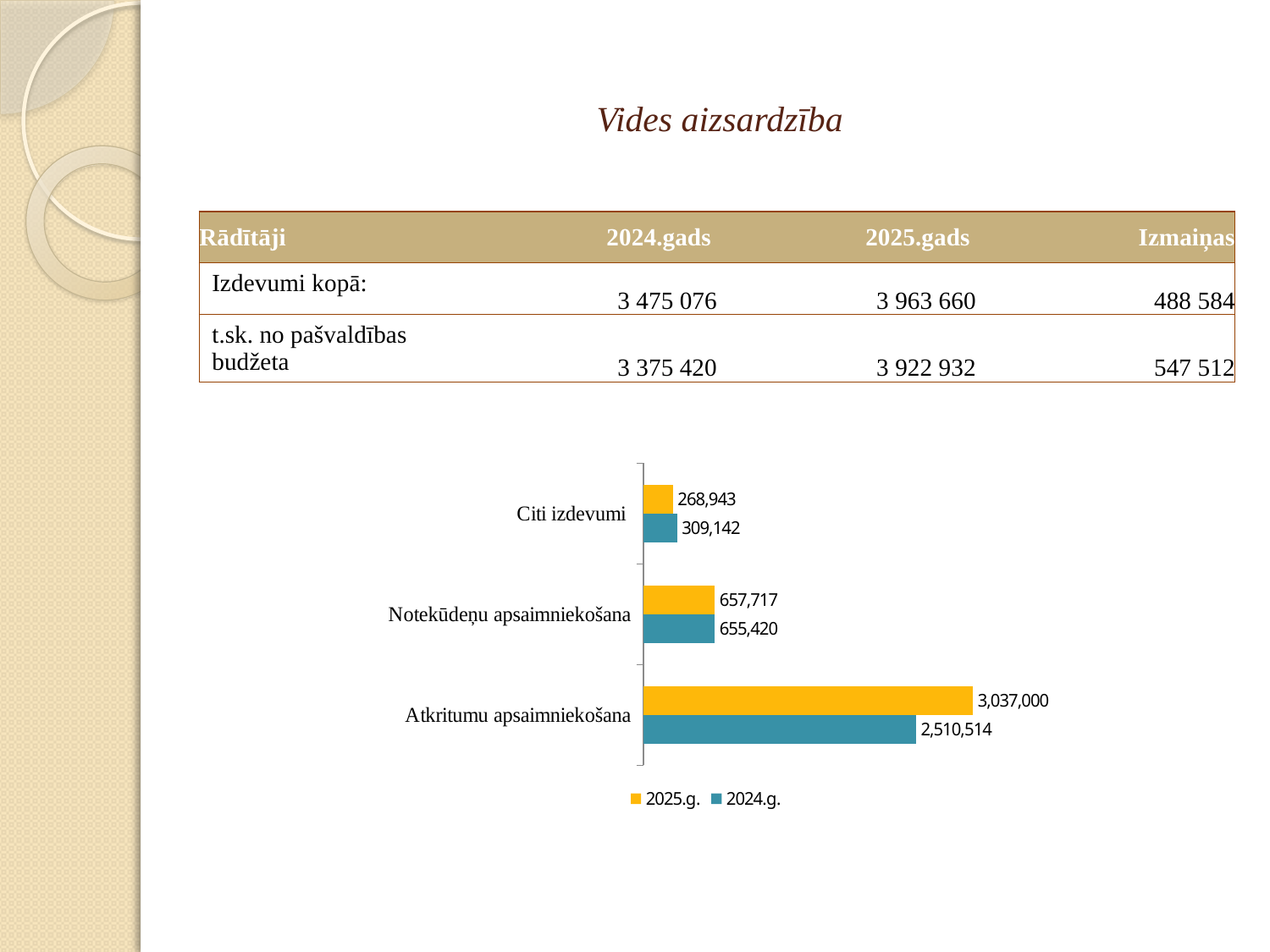
How many categories are shown in the chart? 3 How many series does the chart legend list? 2 What is the 2025.g. value for Notekūdeņu apsaimniekošana? 657,717 What is the difference between the 2025.g. and 2024.g. values for Atkritumu apsaimniekošana? 526,486 What is the 2025.g. value for Atkritumu apsaimniekošana? 3,037,000 What is the 2024.g. value for Atkritumu apsaimniekošana? 2,510,514 Which category has the highest 2025.g. value? Atkritumu apsaimniekošana What is the 2024.g. value for Citi izdevumi? 309,142 Which category has the lowest 2024.g. value? Citi izdevumi What type of chart is shown on the slide? bar chart Which series is shown in orange in the chart? 2025.g. For Citi izdevumi, which is larger: the 2025.g. value or the 2024.g. value? 2024.g.